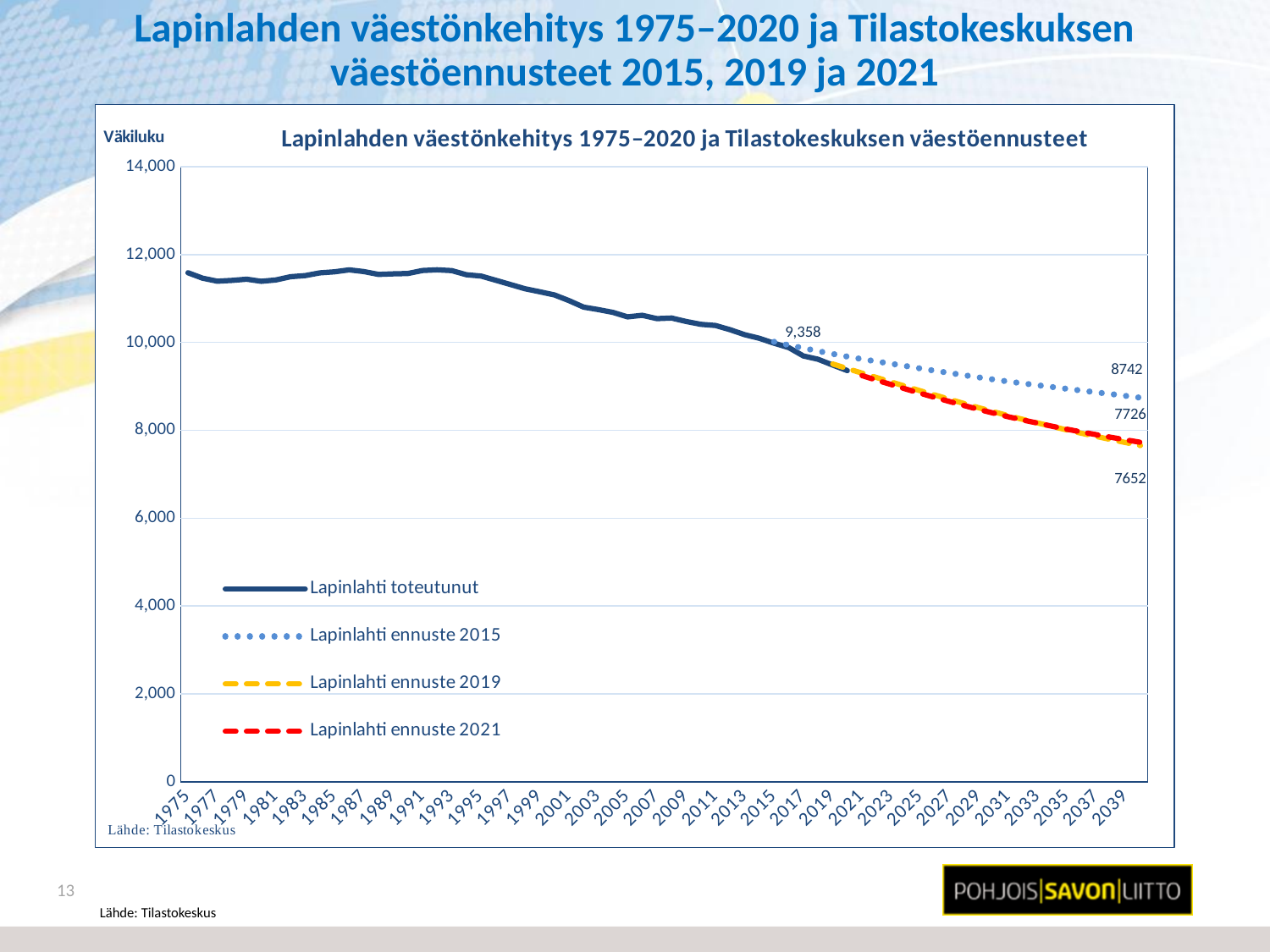
Does the Lapinlahti toteutunut line generally rise or fall from 1975 to 2020? fall What is the difference between the labelled values 8742 and 7652? 1090 Which labelled end value is larger, 8742 or 7726? 8742 What is the end value labelled for the Lapinlahti ennuste 2015 series? 8742 What kind of chart is shown on the slide? line chart Is the Lapinlahti ennuste 2021 value in 2039 greater or less than 8,000? less Is the Lapinlahti toteutunut value in 2019 greater or less than 10,000? less Is the Lapinlahti toteutunut value in 1975 greater or less than 11,000? greater How many series does the chart legend list? 4 What label is shown on the vertical axis of the chart? Väkiluku What is the highest data label printed on the chart? 9,358 What is the lowest data label printed on the chart? 7652